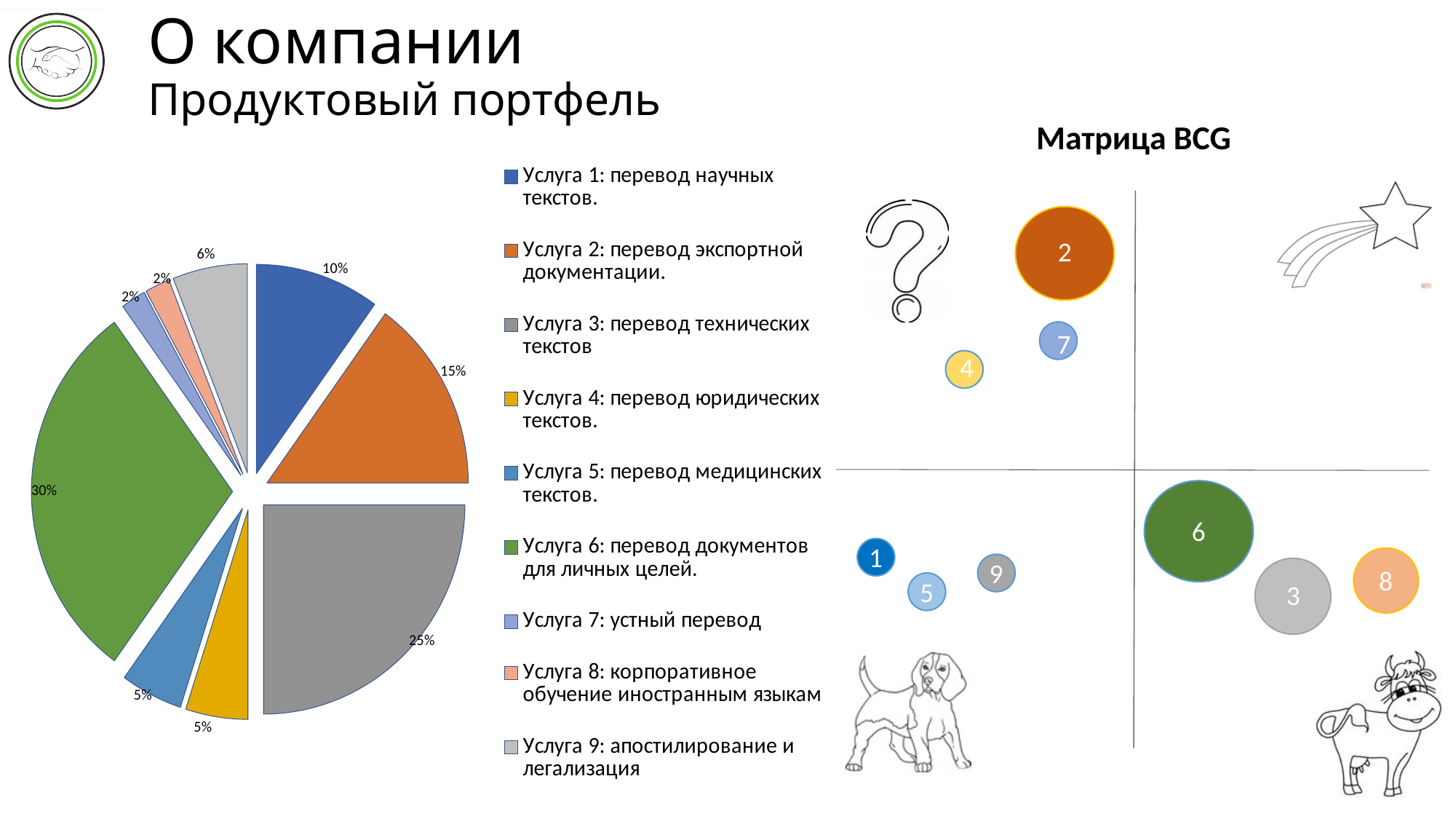
How many slices does the pie chart have? 9 In the pie chart, what share does Услуга 6 (перевод документов для личных целей) have? 30% What kind of chart is shown on the left of the slide? Pie chart In the pie chart, what share does Услуга 9 (апостилирование и легализация) have? 6% What colour is the slice for Услуга 6 in the pie chart? Green In the pie chart, what is the difference between the shares of Услуга 6 and Услуга 3? 5% In the pie chart, which is larger: the share of Услуга 2 or the share of Услуга 1? Услуга 2 Which service has the largest slice in the pie chart? Услуга 6: перевод документов для личных целей In the pie chart, what share does Услуга 2 (перевод экспортной документации) have? 15% In the pie chart, what share does Услуга 3 (перевод технических текстов) have? 25% In the pie chart, what share does Услуга 1 (перевод научных текстов) have? 10% How many entries does the legend of the pie chart list? 9